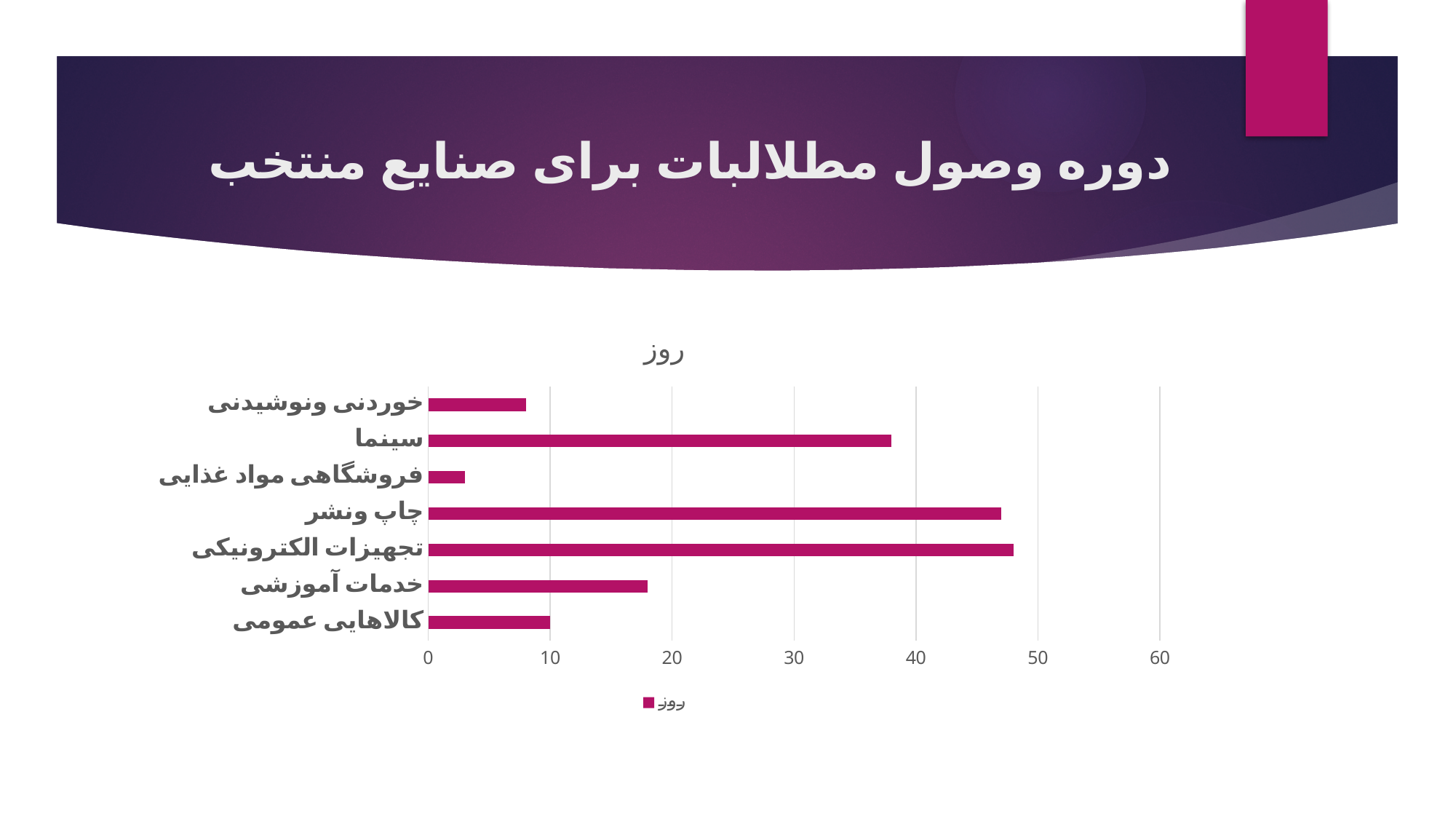
Which category has the lowest value? فروشگاهی مواد غذایی Is the value for خدمات آموزشی greater or less than 20? less What is the title of the chart? روز How many series does the legend list? 1 Is the value for تجهیزات الکترونیکی greater or less than 40? greater What is the value for کالاهایی عمومی? 10 Is the value for سینما greater or less than 30? greater How many categories are plotted in the chart? 7 What kind of chart is shown on the slide? bar chart Which is larger, the value for چاپ ونشر or the value for کالاهایی عمومی? چاپ ونشر Which is larger, the value for سینما or the value for خدمات آموزشی? سینما